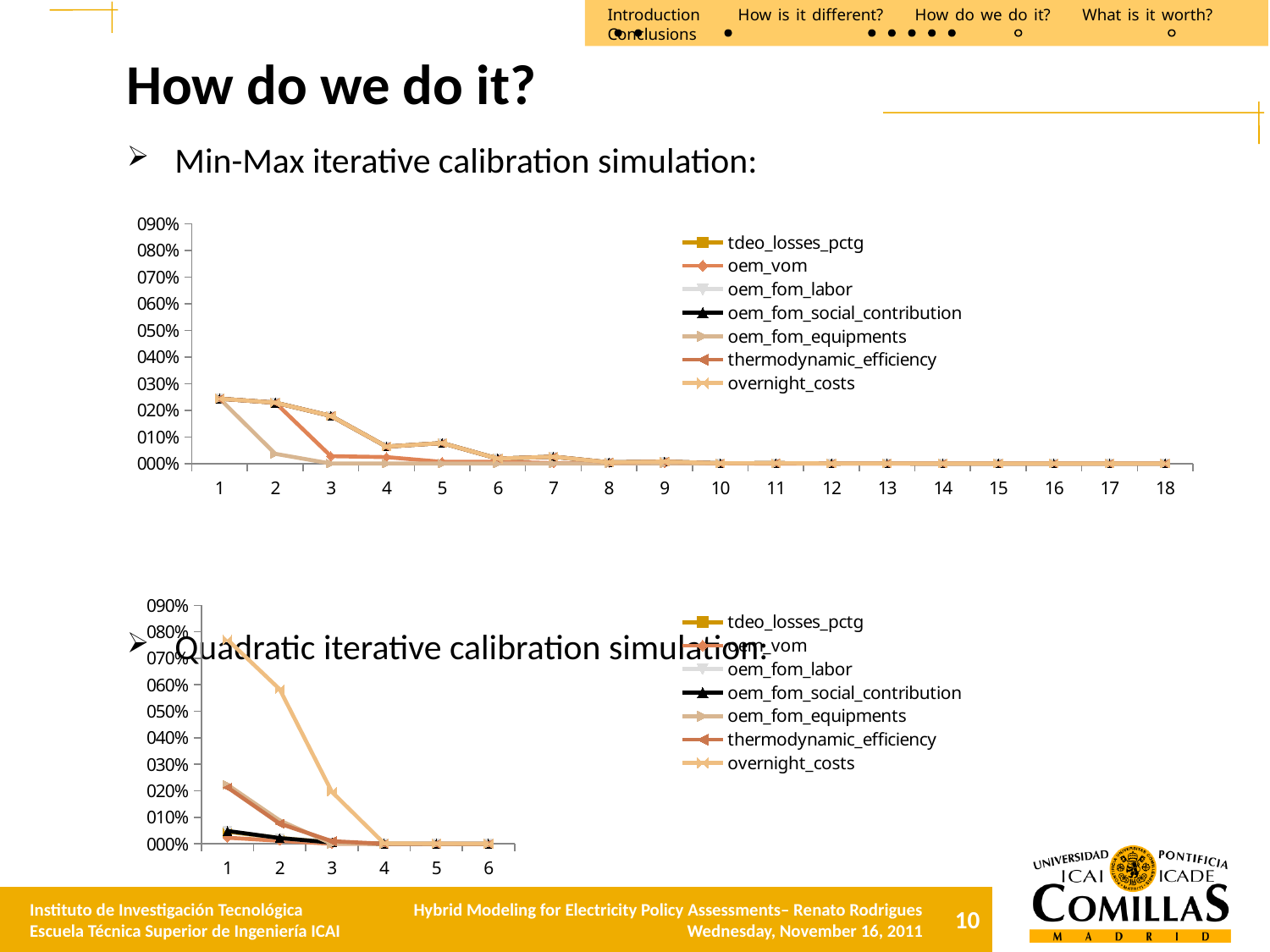
How many iterations are shown on the x axis of the bottom chart? 6 What kind of chart is the bottom chart (Quadratic iterative calibration simulation)? line chart What is the last series entry listed in the legend of the top chart? overnight_costs What kind of chart is the top chart (Min-Max iterative calibration simulation)? line chart In the top chart, do the values of the series rise or fall as the iteration number increases? fall In the bottom chart, do the values of the series rise or fall as the iteration number increases? fall In the bottom chart, is the value for overnight_costs at iteration 1 greater or less than 70%? greater In the top chart, is the highest value at iteration 1 greater or less than 30%? less How many iterations are shown on the x axis of the top chart? 18 How many series does the legend of the bottom chart list? 7 How many series does the legend of the top chart list? 7 In the bottom chart, is the value for overnight_costs at iteration 3 greater or less than 30%? less